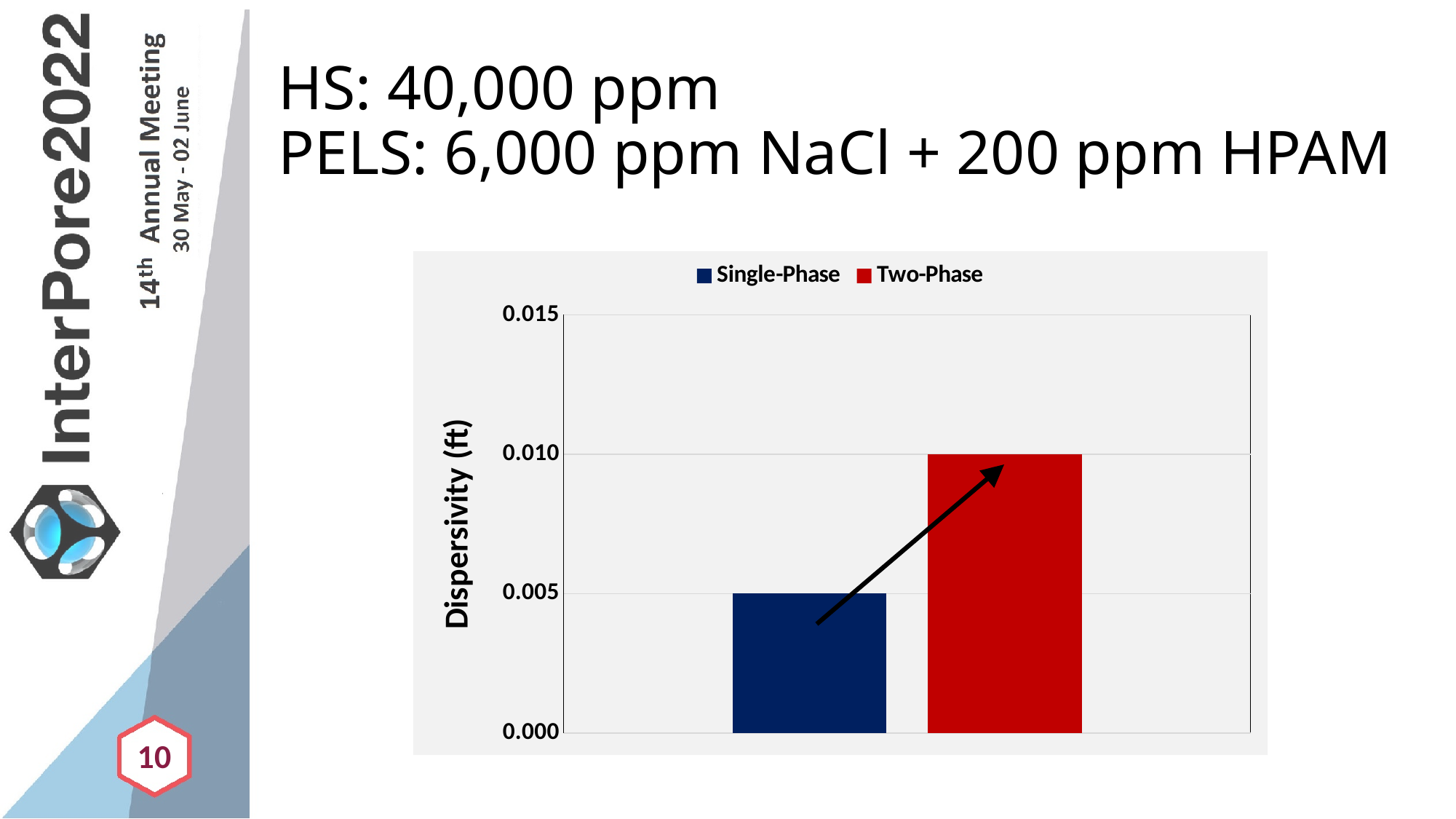
What kind of chart is shown on the slide? bar chart What is the label of the vertical axis of the chart? Dispersivity (ft) What is the dispersivity value for Two-Phase? 0.010 How many bars are plotted in the chart? 2 What is the dispersivity value for Single-Phase? 0.005 How many series does the chart legend list? 2 What is the difference in dispersivity between Two-Phase and Single-Phase? 0.005 Is the dispersivity value for Two-Phase greater or less than 0.015? less Which series has the lowest dispersivity in the chart? Single-Phase What are the two series named in the chart legend? Single-Phase and Two-Phase What is the highest value shown on the vertical axis of the chart? 0.015 Which series has the higher dispersivity, Single-Phase or Two-Phase? Two-Phase